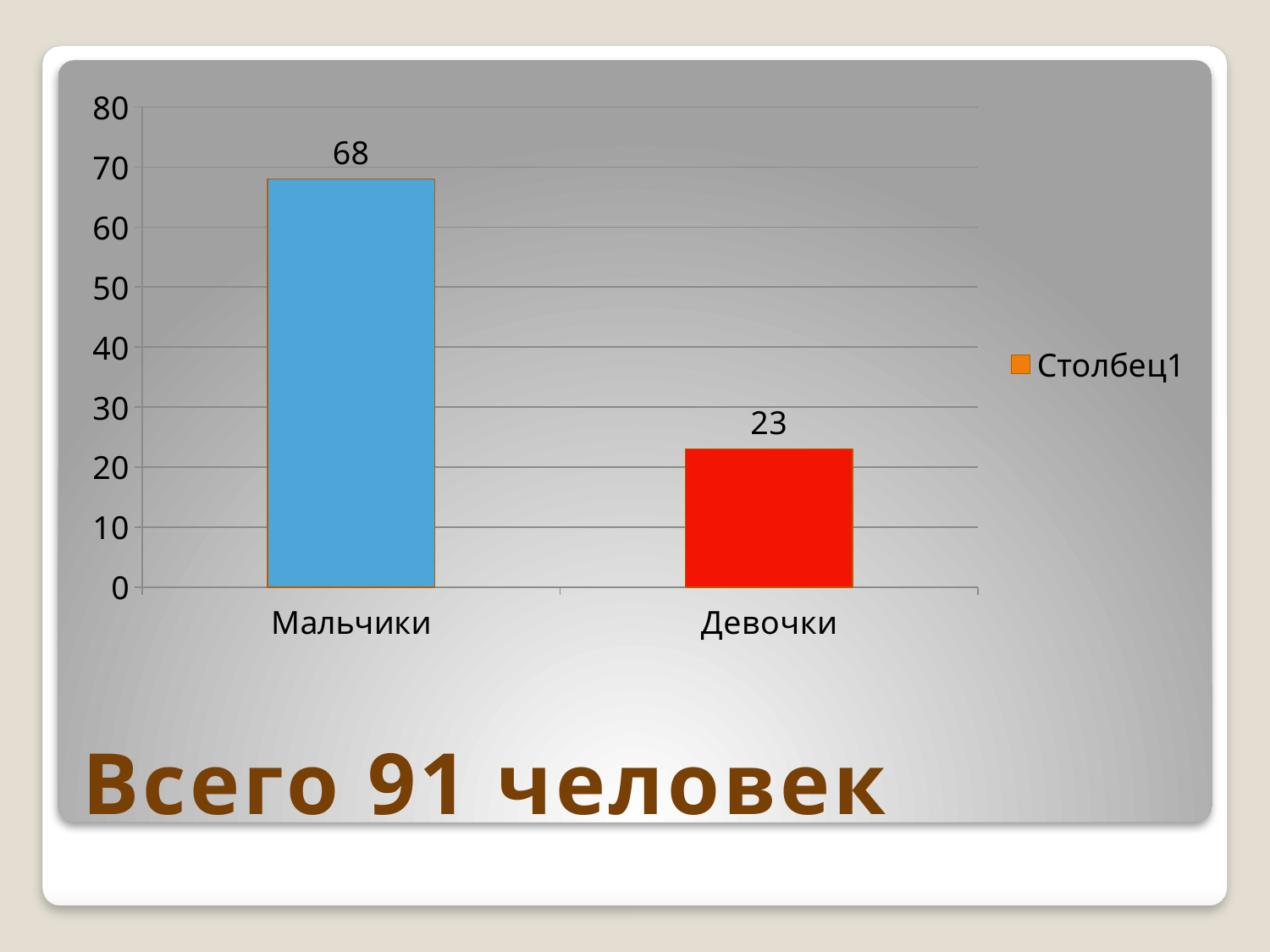
Which category has the lowest value? Девочки How many categories are shown on the x axis? 2 Is the value for Мальчики greater or less than 60? greater What kind of chart is shown on the slide? bar chart How many series does the legend list? 1 Which is larger, the value for Мальчики or the value for Девочки? Мальчики What is the value for Мальчики? 68 Is the value for Девочки greater or less than 30? less What is the name of the series listed in the legend? Столбец1 What is the difference between the values for Мальчики and Девочки? 45 Which category has the highest value? Мальчики What is the value for Девочки? 23